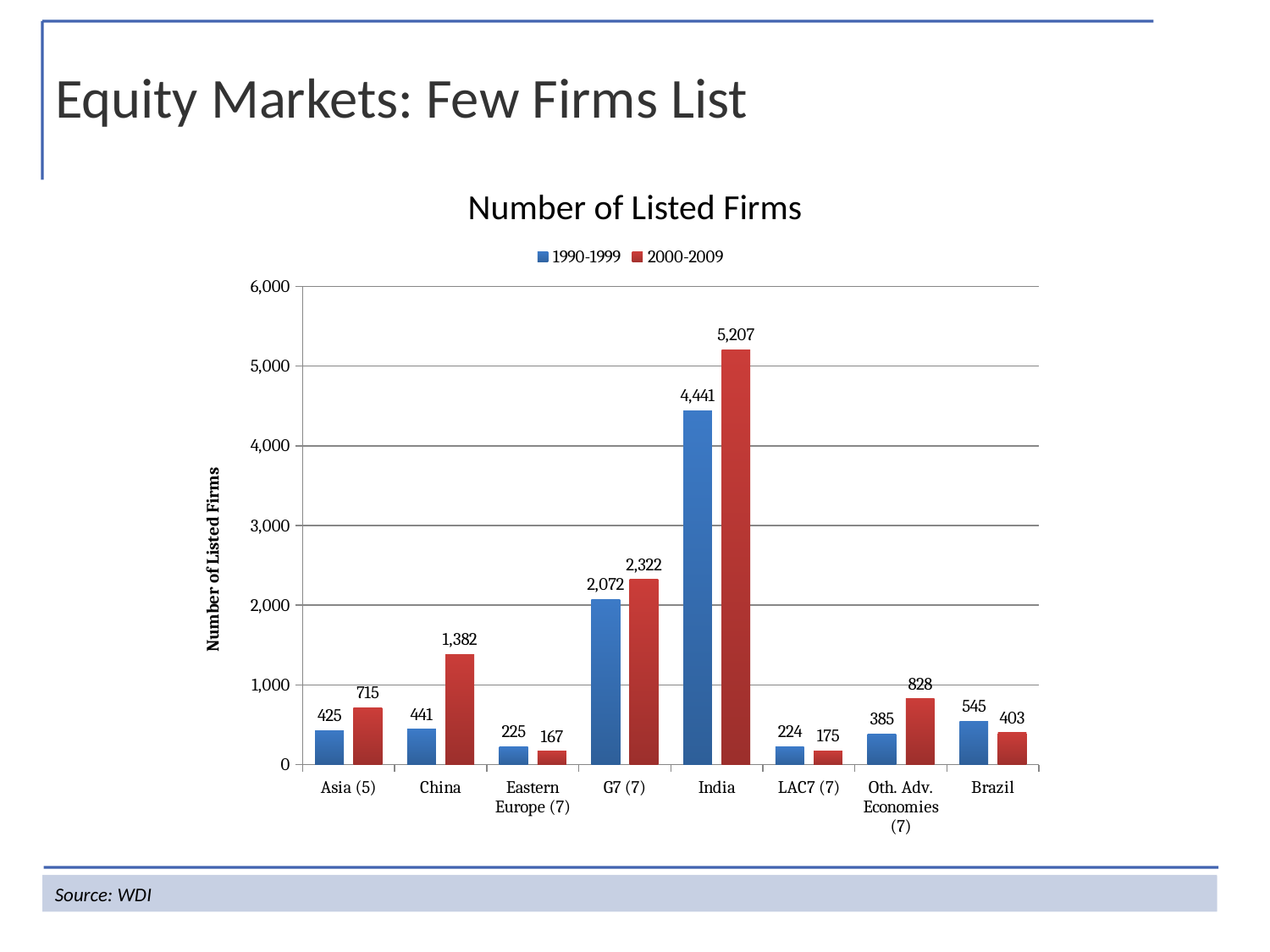
Which category has the highest number of listed firms in 1990-1999? India What kind of chart is shown on the slide? Bar chart What is the number of listed firms for India in 2000-2009? 5,207 How many series does the legend list? 2 Which is larger for Brazil: the 1990-1999 value or the 2000-2009 value? 1990-1999 Which category has the lowest number of listed firms in 2000-2009? Eastern Europe (7) What is the number of listed firms for China in 1990-1999? 441 What is the value for Oth. Adv. Economies (7) in the 2000-2009 series? 828 What is the difference between the 2000-2009 and 1990-1999 values for India? 766 What is the difference between the 2000-2009 and 1990-1999 values for China? 941 What is the title of the chart? Number of Listed Firms How many categories are shown on the x axis? 8